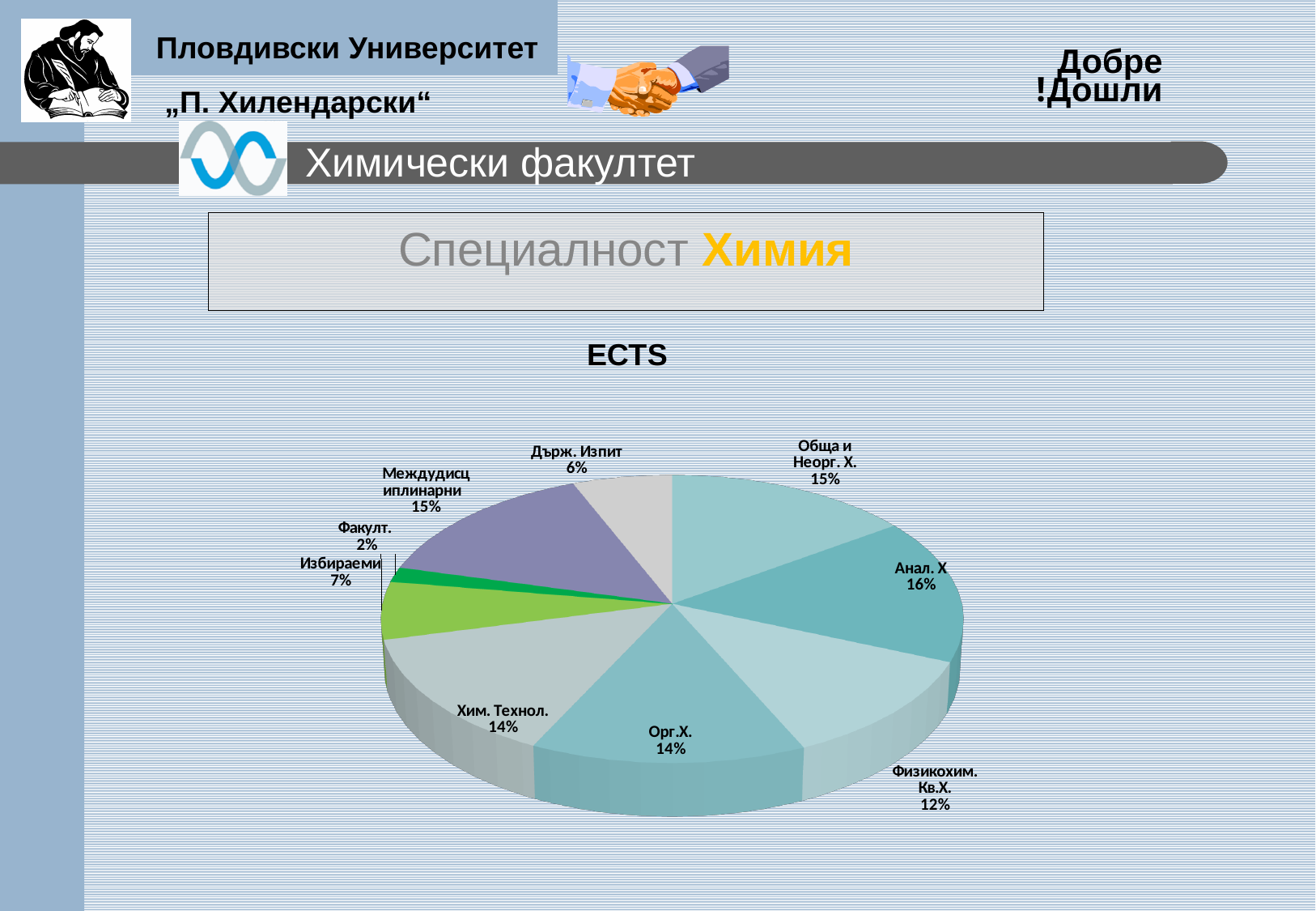
What is the value shown for Държ. Изпит? 6% Which category has the largest slice of the pie? Анал. Х How many slices does the pie chart have? 9 What kind of chart is shown on the slide? pie chart What is the title of the chart? ECTS What is the value shown for Избираеми? 7% What is the difference between the shares of Обща и Неорг. Х. and Физикохим. Кв.Х.? 3% Which category has the smallest slice of the pie? Факулт. What is the combined share of Избираеми and Факулт.? 9% What share of the pie does Анал. Х have? 16% What is the value shown for Физикохим. Кв.Х.? 12% Which is larger, the share for Междудисциплинарни or the share for Орг.Х.? Междудисциплинарни